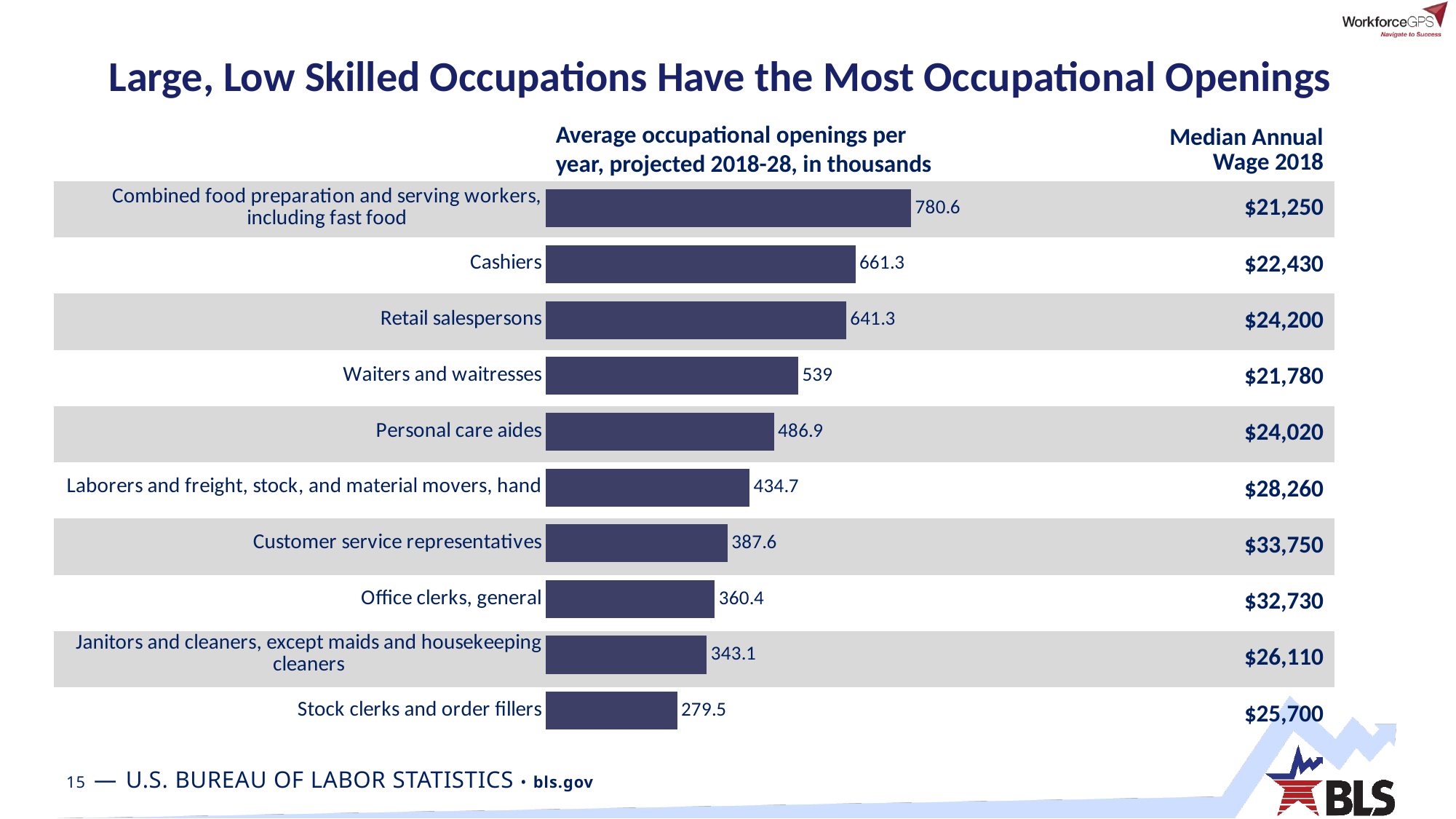
What kind of chart is shown on the slide? Bar chart Which occupation has the highest average occupational openings per year? Combined food preparation and serving workers, including fast food Which has more average occupational openings per year, Customer service representatives or Janitors and cleaners, except maids and housekeeping cleaners? Customer service representatives Which occupation has the lowest average occupational openings per year? Stock clerks and order fillers What is the median annual wage 2018 shown for Customer service representatives? $33,750 What is the average occupational openings per year value for Cashiers? 661.3 What is the average occupational openings per year value for Stock clerks and order fillers? 279.5 How many occupations are shown in the chart? 10 What is the average occupational openings per year value for Personal care aides? 486.9 What is the difference in average occupational openings per year between Cashiers and Retail salespersons? 20 What is the difference in average occupational openings per year between Waiters and waitresses and Office clerks, general? 178.6 What is the title of the chart's value axis heading? Average occupational openings per year, projected 2018-28, in thousands